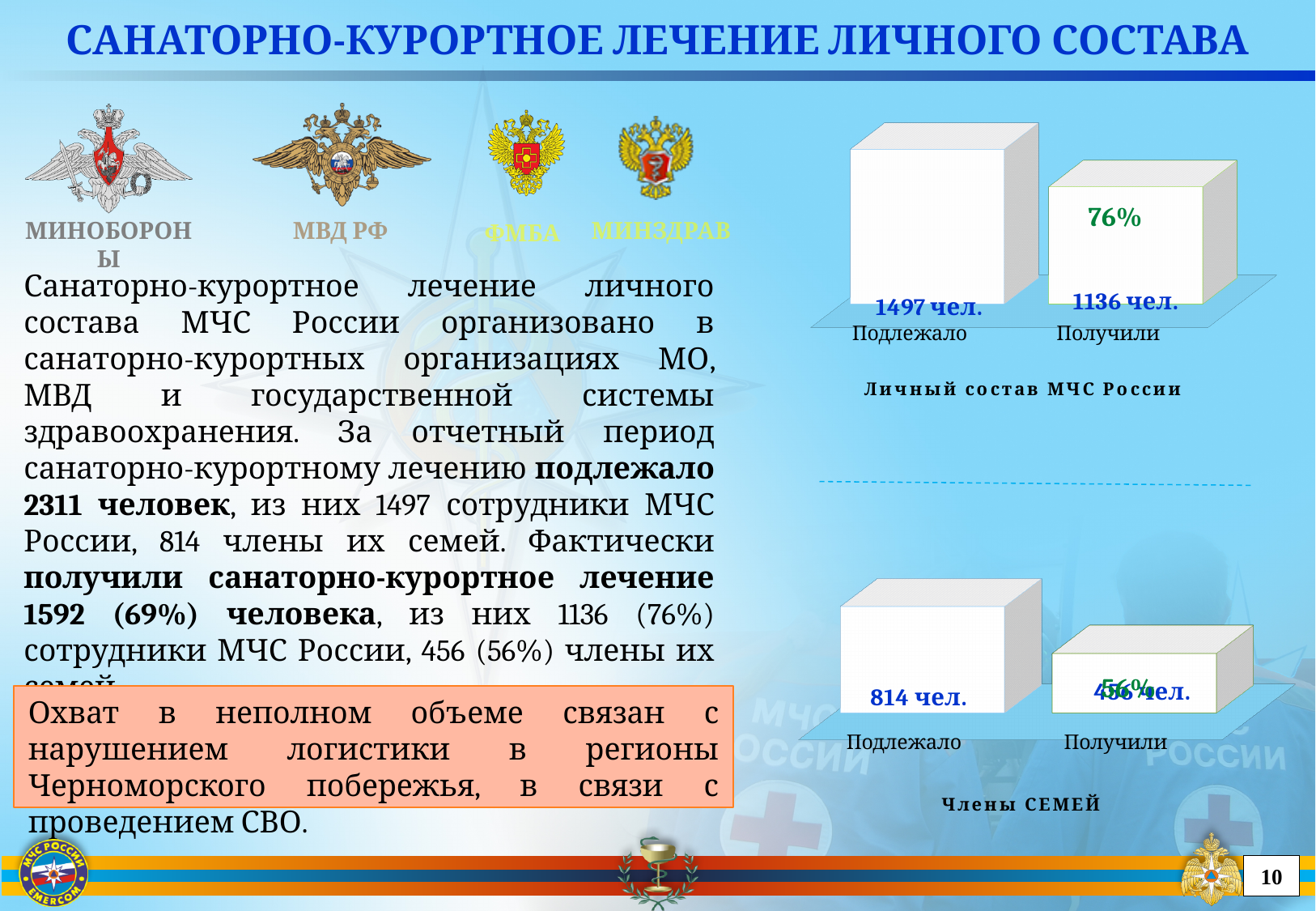
In the chart titled "Личный состав МЧС России", what is the value for "Получили"? 1136 чел. How many categories does the chart titled "Члены СЕМЕЙ" show? 2 In the chart titled "Члены СЕМЕЙ", which category has the lower value? Получили In the chart titled "Члены СЕМЕЙ", what is the difference between "Подлежало" and "Получили"? 358 чел. In the chart titled "Личный состав МЧС России", what is the value for "Подлежало"? 1497 чел. In the chart titled "Члены СЕМЕЙ", what is the value for "Подлежало"? 814 чел. In the chart titled "Личный состав МЧС России", what is the difference between "Подлежало" and "Получили"? 361 чел. What kind of chart is the chart titled "Личный состав МЧС России"? Bar chart In the chart titled "Члены СЕМЕЙ", what percentage is printed on the "Получили" bar? 56% In the chart titled "Личный состав МЧС России", what percentage is printed on the "Получили" bar? 76% In the chart titled "Члены СЕМЕЙ", what is the value for "Получили"? 456 чел. In the chart titled "Личный состав МЧС России", which category has the higher value? Подлежало